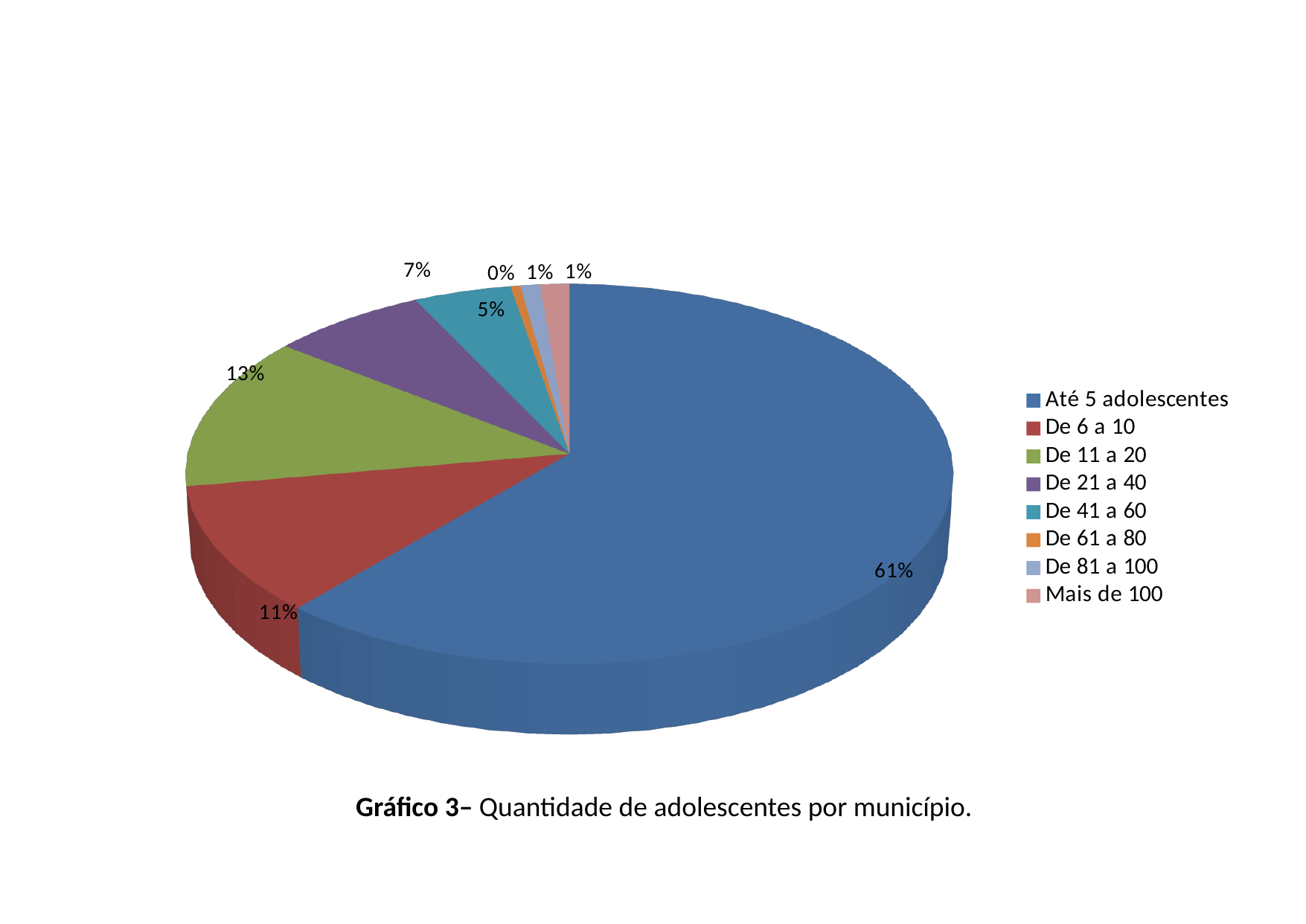
What is the value shown for 'De 41 a 60'? 5% What is the value shown for 'De 21 a 40'? 7% What is the title of the chart? Gráfico 3– Quantidade de adolescentes por município. What kind of chart is shown on the slide? pie chart How many categories does the legend list? 8 Which category has the largest slice of the pie? Até 5 adolescentes What is the value shown for 'De 6 a 10'? 11% What percentage of the pie does 'Até 5 adolescentes' represent? 61% What is the value shown for 'De 11 a 20'? 13% What is the difference between the values for 'De 11 a 20' and 'De 6 a 10'? 2% Which is larger, the slice for 'De 21 a 40' or the slice for 'De 41 a 60'? De 21 a 40 Which category has the smallest slice of the pie? De 61 a 80